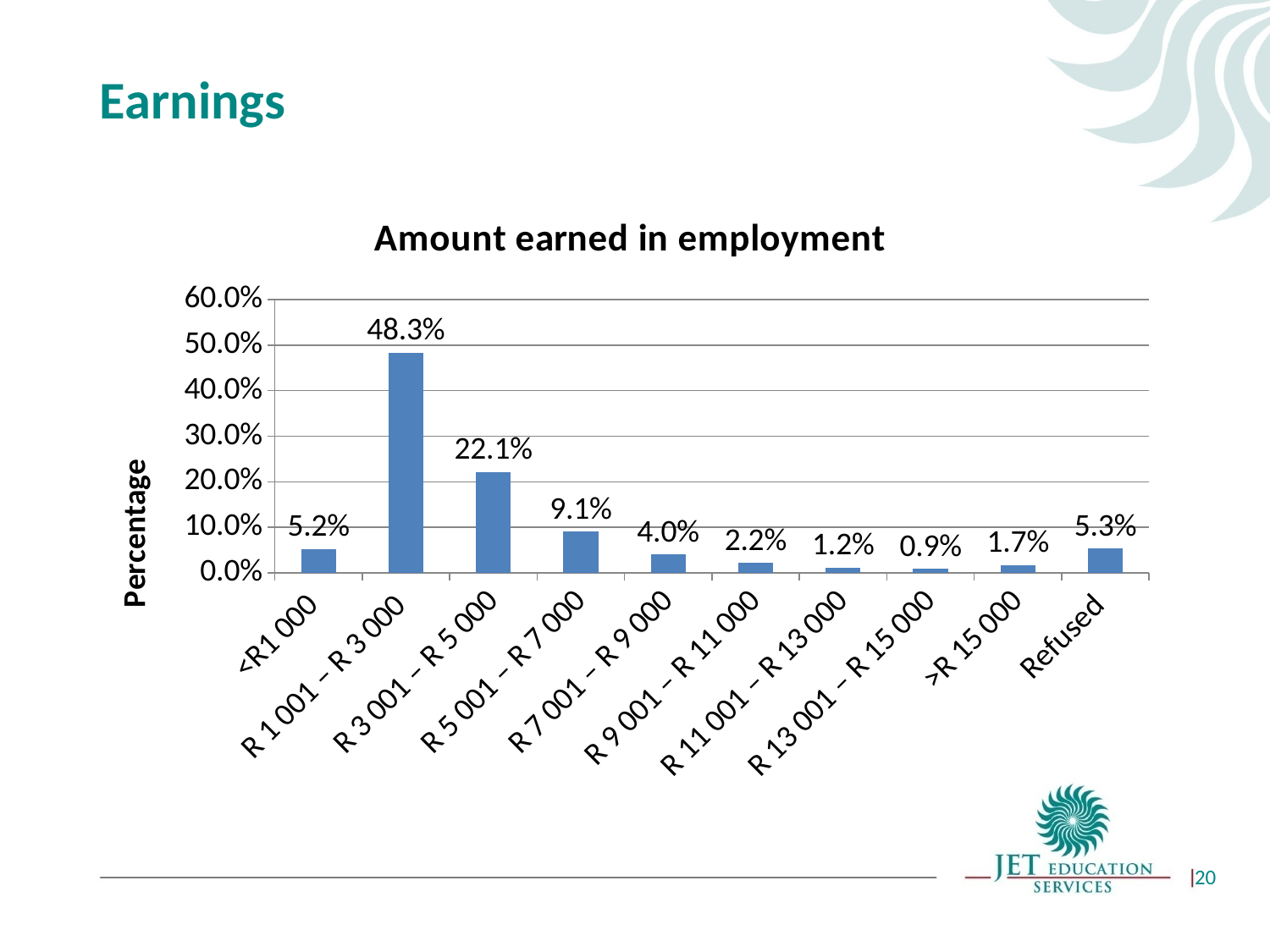
Which earnings category has the lowest percentage? R 13 001 – R 15 000 What percentage earned R 3 001 – R 5 000? 22.1% Is the value for R 5 001 – R 7 000 greater or less than 10.0%? less What percentage earned more than R 15 000? 1.7% How many categories are shown on the x axis? 10 Which earnings category has the highest percentage? R 1 001 – R 3 000 What percentage of respondents refused to answer? 5.3% What is the difference in percentage points between R 1 001 – R 3 000 and R 3 001 – R 5 000? 26.2% Which is larger: the percentage for <R1 000 or for Refused? Refused What percentage earned R 1 001 – R 3 000? 48.3% What type of chart is shown? Bar chart What is the title of the chart? Amount earned in employment